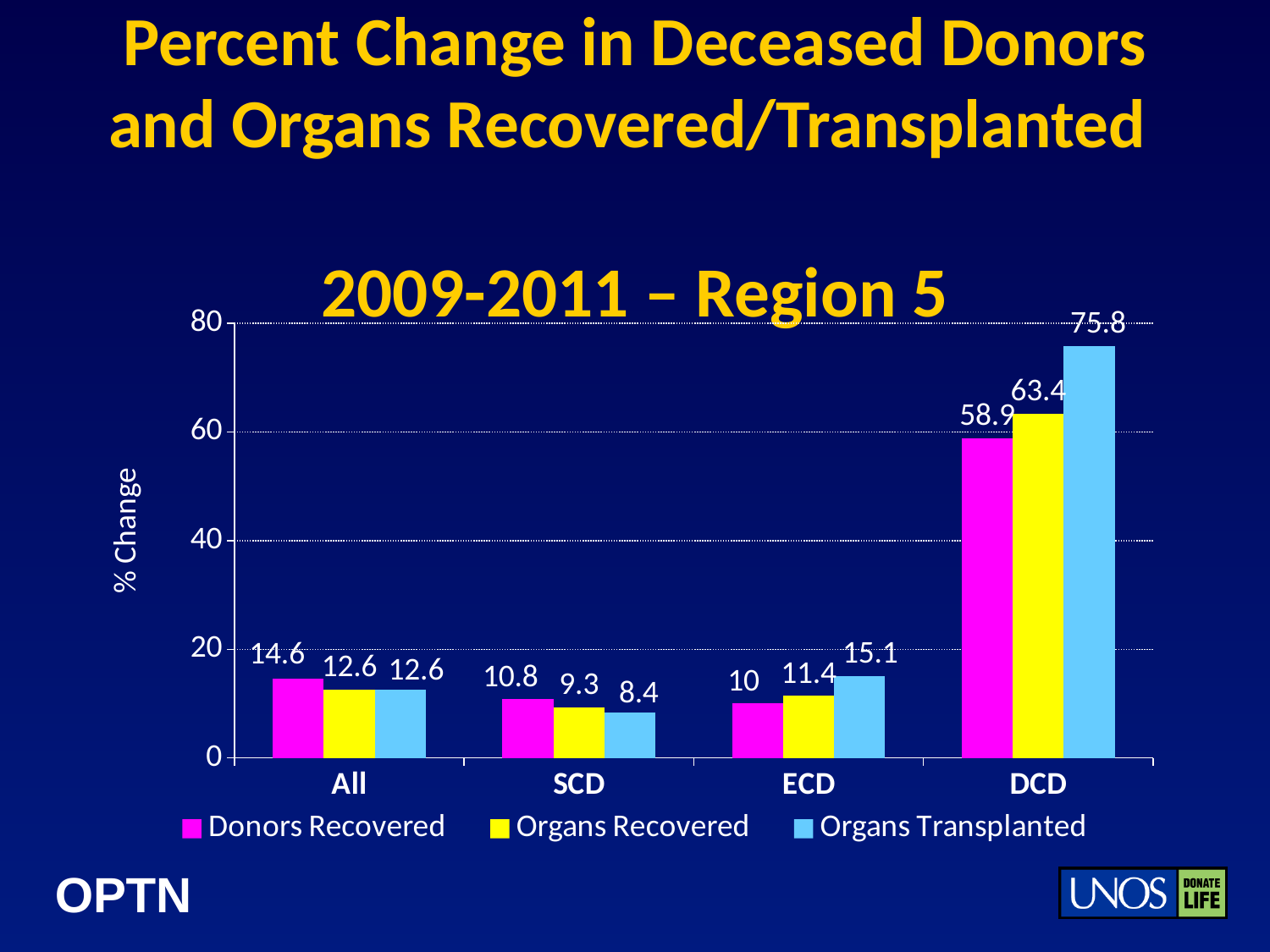
How many series does the legend list? 3 What is the value for Donors Recovered in the DCD category? 58.9 How many categories are shown on the x axis? 4 Is the value for Organs Recovered in the DCD category greater or less than 60? greater Which is larger in the ECD category: Donors Recovered or Organs Transplanted? Organs Transplanted What is the label of the y axis? % Change What is the value for Organs Transplanted in the ECD category? 15.1 Which category has the lowest value for Organs Transplanted? SCD What kind of chart is shown on the slide? bar chart What is the value for Organs Recovered in the SCD category? 9.3 What is the difference between Organs Transplanted and Donors Recovered in the DCD category? 16.9 Which category has the highest value for Organs Transplanted? DCD